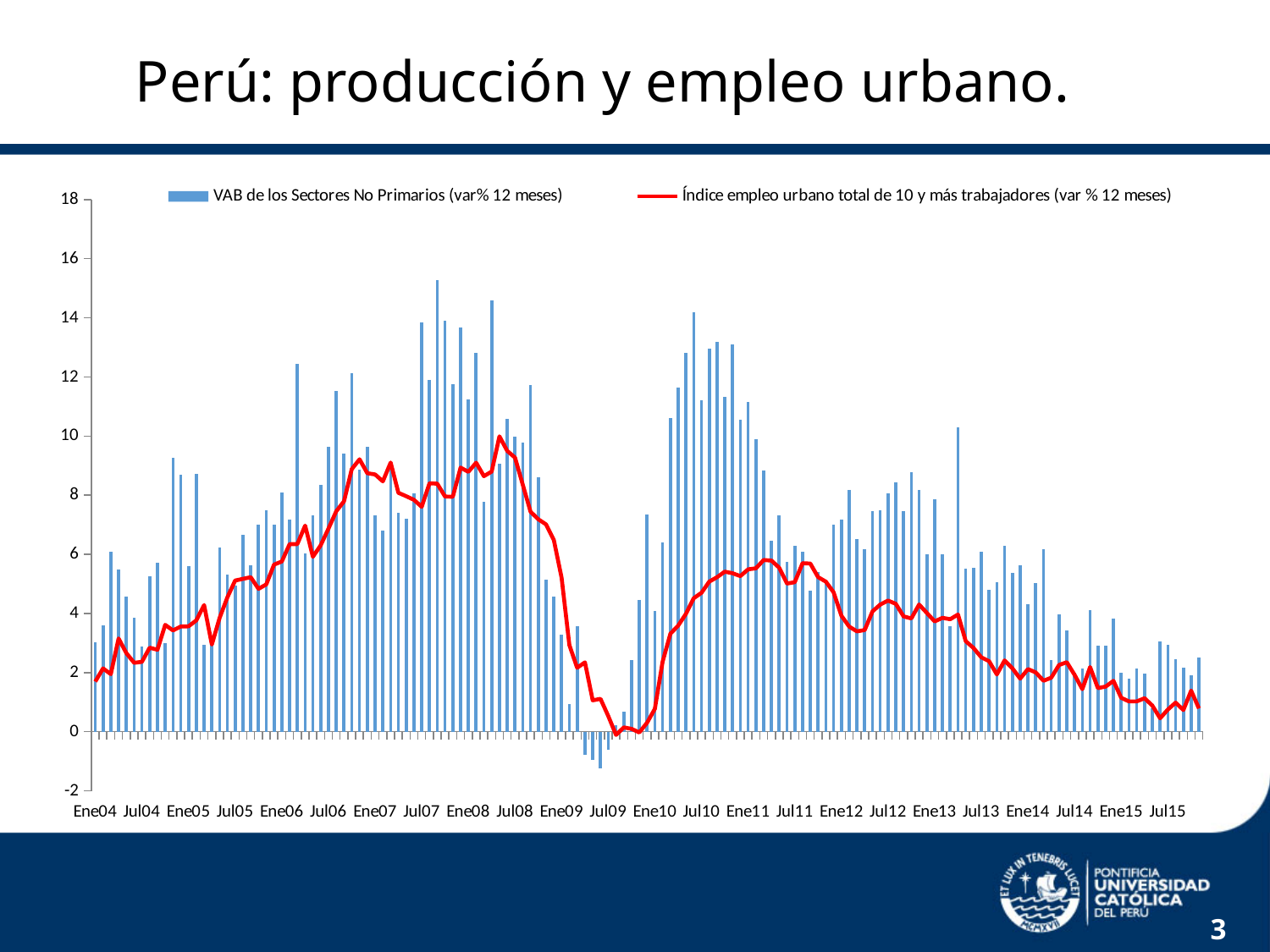
Does the Índice empleo urbano line rise or fall between Ene09 and Jul09? fall How many labels are shown along the x axis of the chart? 24 Which is larger, the Índice empleo urbano line value at Jul08 or at Jul15? Jul08 Is the Índice empleo urbano line value at Jul08 greater or less than 8? greater Is the Índice empleo urbano line value at Jul15 greater or less than 2? less Is the VAB de los Sectores No Primarios bar at Jul09 greater or less than 0? less Which series is drawn as a red line in the chart? Índice empleo urbano total de 10 y más trabajadores (var % 12 meses) How many series does the chart's legend list? 2 Does the Índice empleo urbano line rise or fall between Jul09 and Jul10? rise What kind of chart is shown on the slide? A combined bar and line chart What is the title of the slide containing the chart? Perú: producción y empleo urbano.